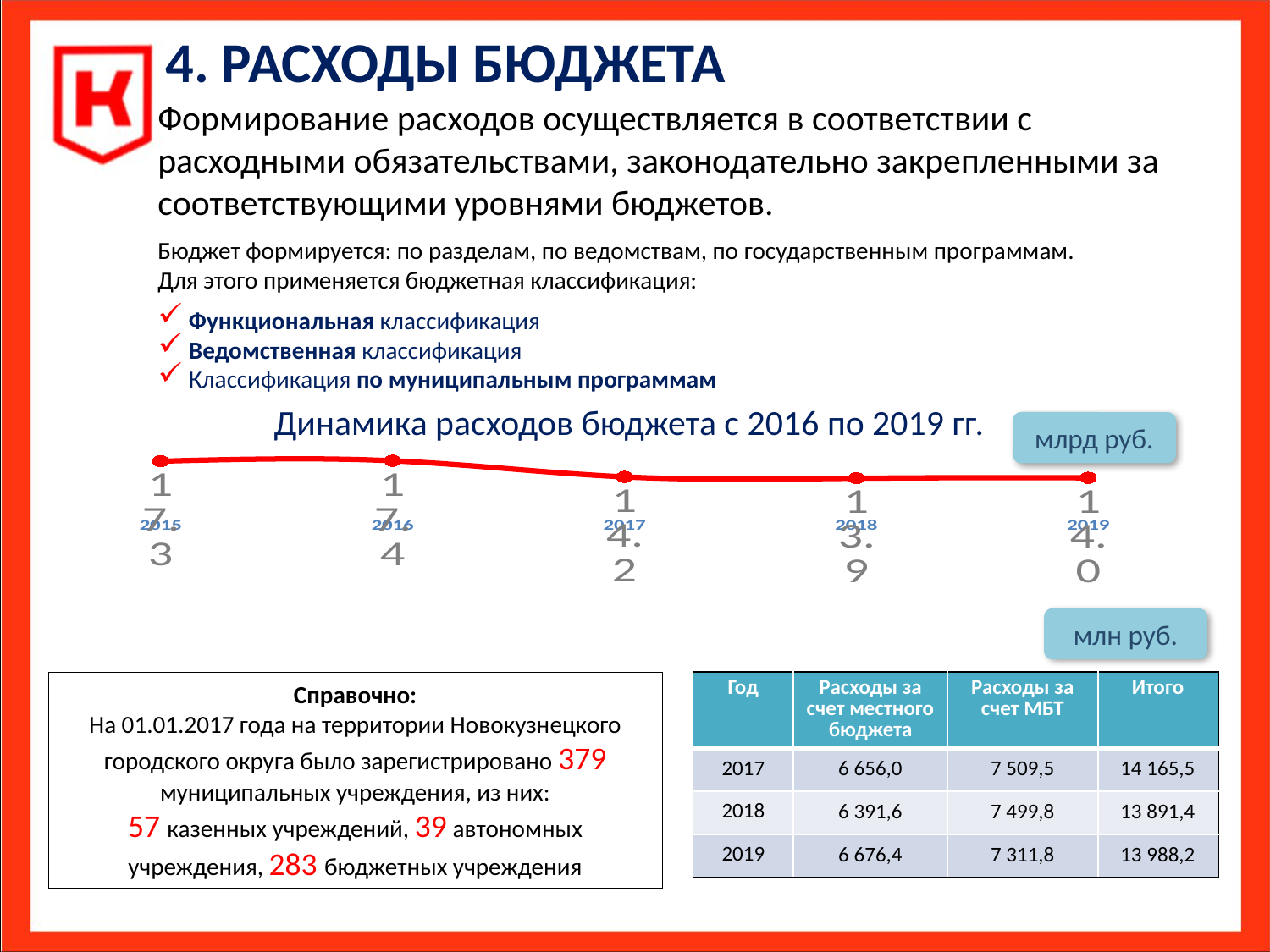
What value is labelled for 2017 on the line chart? 14.2 What value is labelled for 2019 on the line chart? 14.0 What value is labelled for 2018 on the line chart? 13.9 How many data points are plotted on the line chart 'Динамика расходов бюджета с 2016 по 2019 гг.'? 5 On the line chart, which year has the larger value: 2015 or 2018? 2015 What kind of chart is used to show the dynamics of budget expenditures from 2016 to 2019? line chart In what units are the values of the line chart given, according to the label next to it? млрд руб. What is the title of the line chart on the slide? Динамика расходов бюджета с 2016 по 2019 гг. On the line chart, is the value for 2016 larger or smaller than the value for 2017? larger On the line chart, what is the difference between the values for 2017 and 2018? 0.3 Do the values on the line chart generally rise or fall from 2015 to 2019? fall What is the first year shown on the x axis of the line chart? 2015